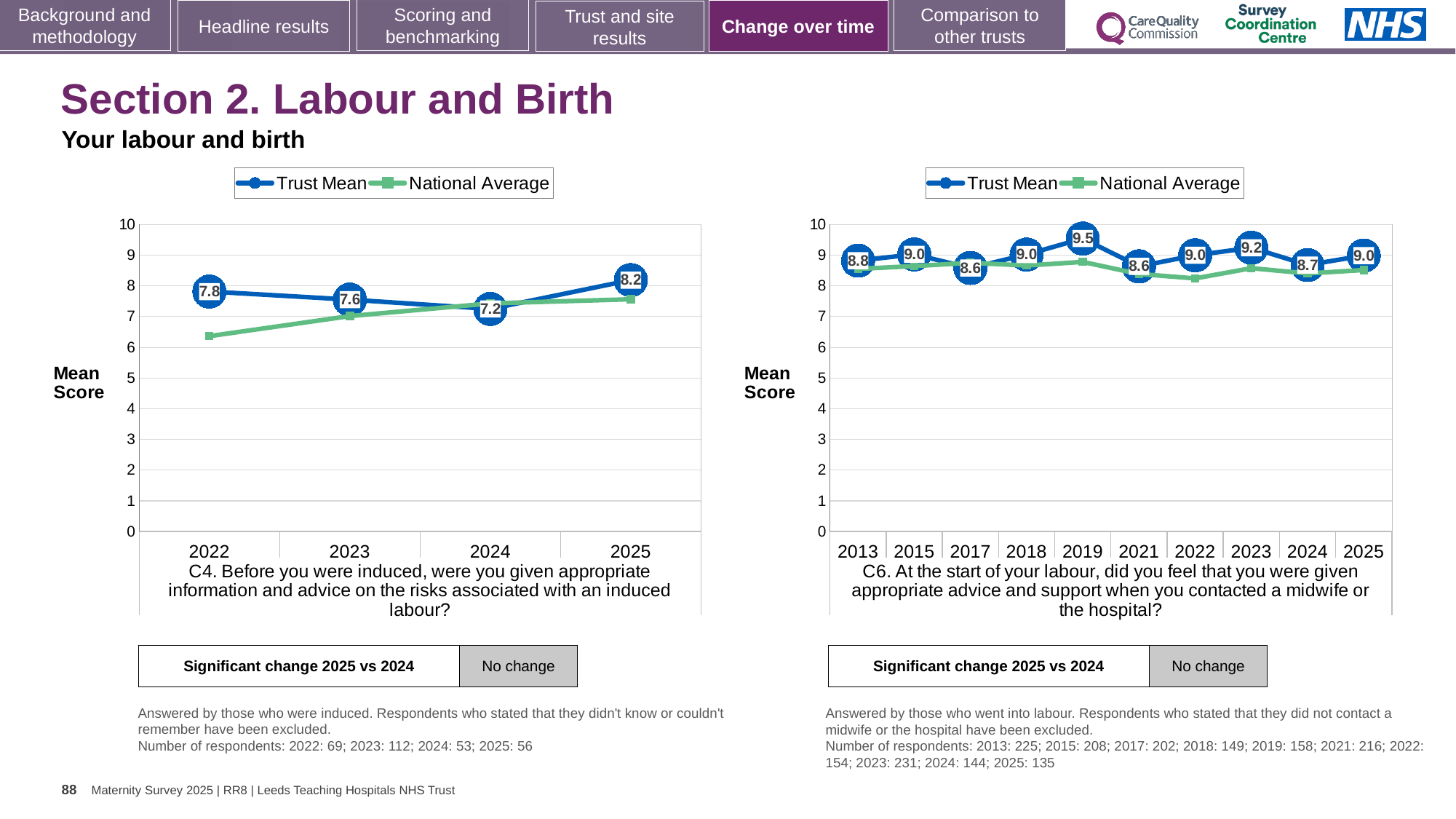
On the left chart (C4), what is the Trust Mean score for 2024? 7.2 On the left chart (C4), is the National Average for 2022 greater or less than 7? less What kind of chart is the left chart (C4)? Line chart On the right chart (C6), how many years are shown on the x axis? 10 On the left chart (C4), what is the difference between the Trust Mean scores for 2025 and 2024? 1.0 On the right chart (C6), which year has the highest Trust Mean score? 2019 How many series does the legend of the right chart (C6) list? 2 On the right chart (C6), what is the Trust Mean score for 2019? 9.5 On the left chart (C4), which year has the lowest Trust Mean score? 2024 On the left chart (C4), how many years are shown on the x axis? 4 On the right chart (C6), which is larger, the Trust Mean for 2023 or the Trust Mean for 2024? 2023 On the left chart (C4), what is the Trust Mean score for 2025? 8.2